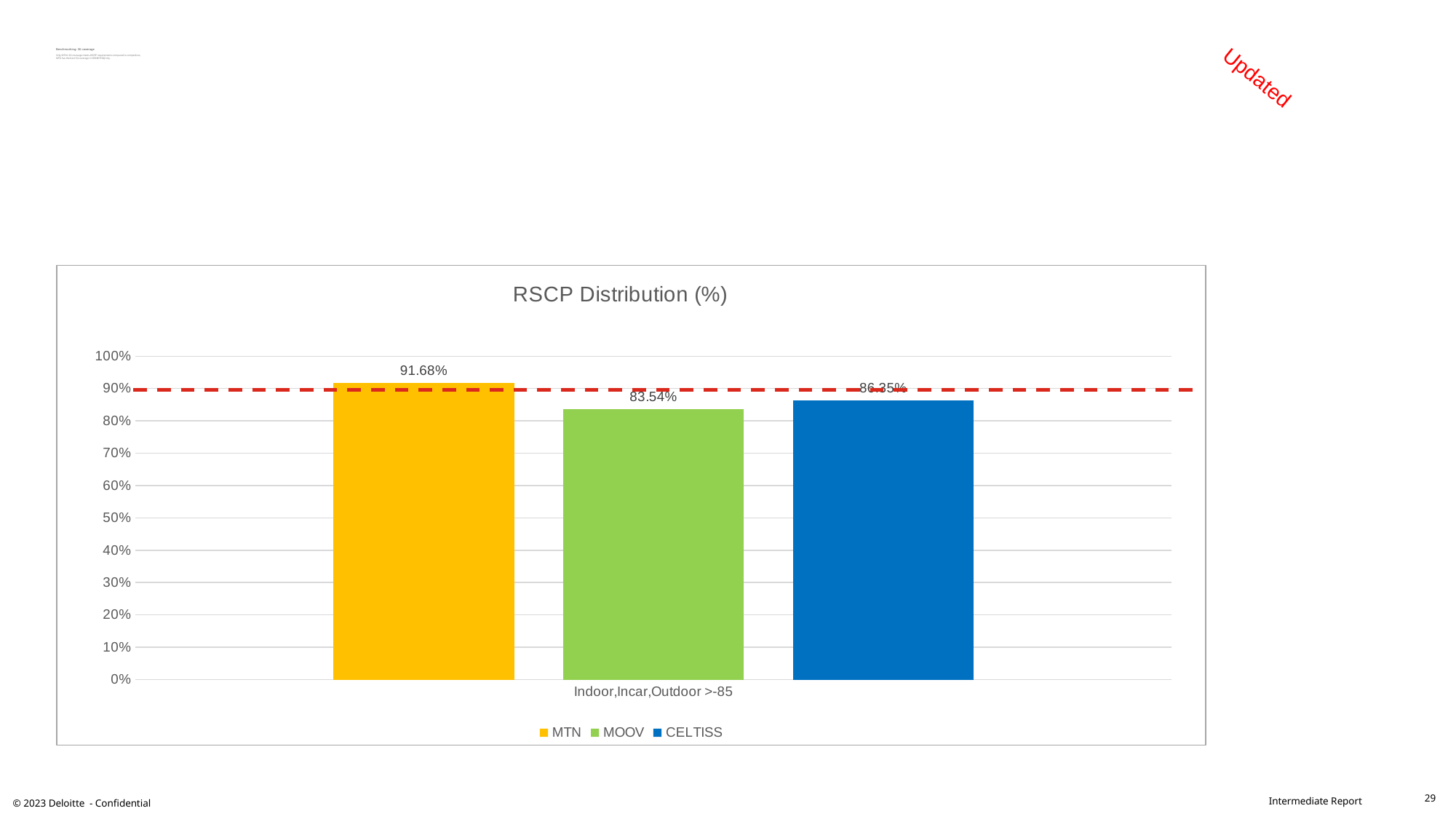
At what level on the y axis is the red dashed line drawn in the RSCP Distribution (%) chart? 90% Which operator has the highest value in the RSCP Distribution (%) chart? MTN What is the value for MTN in the RSCP Distribution (%) chart? 91.68% How many series does the legend of the RSCP Distribution (%) chart list? 3 Which is larger in the RSCP Distribution (%) chart, the value for MTN or the value for CELTISS? MTN Which operator has the lowest value in the RSCP Distribution (%) chart? MOOV What is the difference between the MTN and MOOV values in the RSCP Distribution (%) chart? 8.14% Is the value for MOOV greater or less than 80%? greater Is the value for CELTISS greater or less than 90%? less What is the value for MOOV in the RSCP Distribution (%) chart? 83.54% What kind of chart is shown on the slide? bar chart What is the title of the chart on the slide? RSCP Distribution (%)